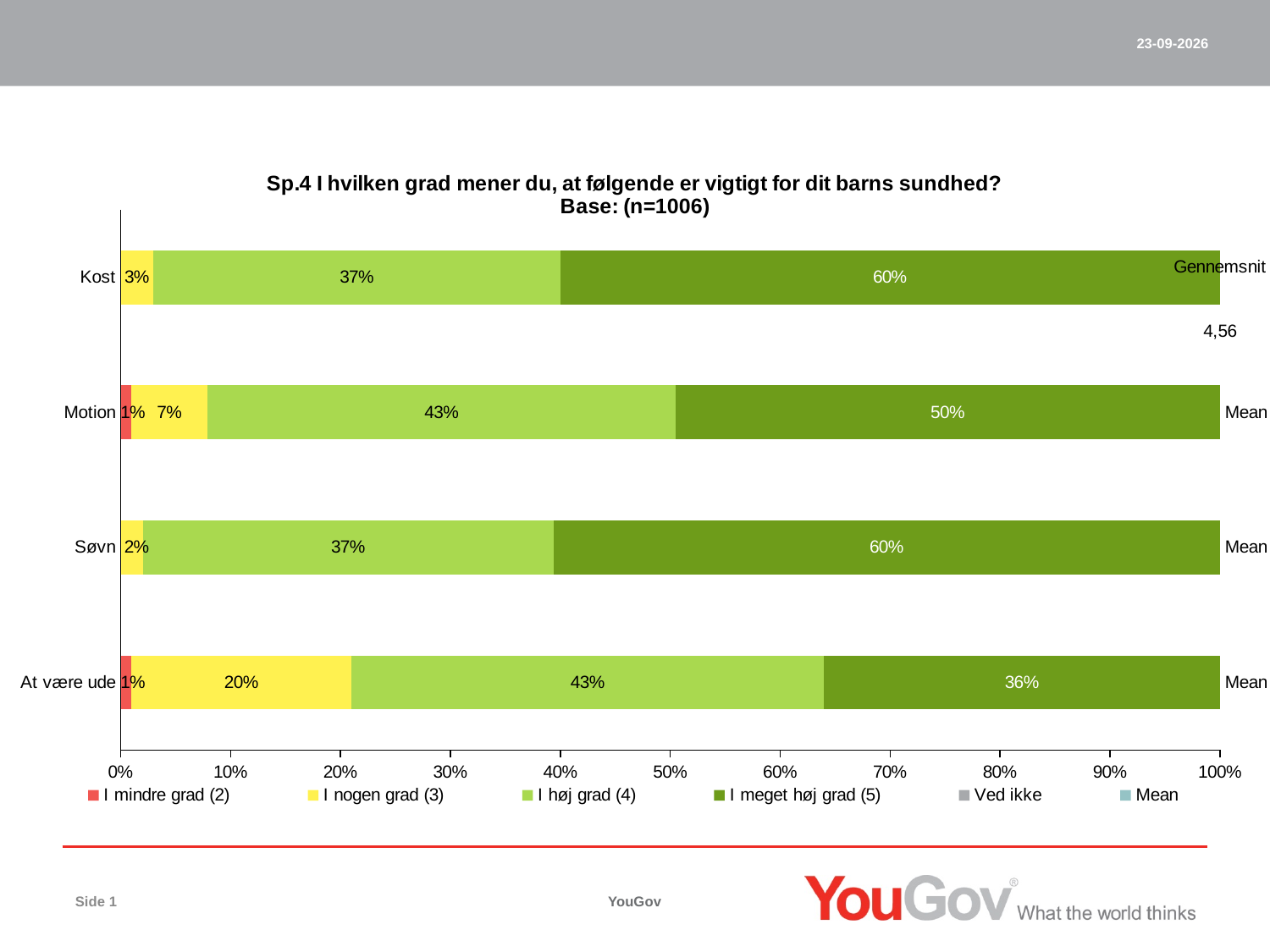
How many categories are shown on the y axis of the chart? 4 What is the value for 'I meget høj grad (5)' for Kost? 60% What is the value for 'I nogen grad (3)' for At være ude? 20% What kind of chart is shown on the slide? Stacked bar chart What is the Gennemsnit (mean) shown for Kost? 4,56 What is the value for 'I meget høj grad (5)' for Søvn? 60% Which category has the highest value for 'I nogen grad (3)'? At være ude What is the value for 'I høj grad (4)' for Motion? 43% How many entries does the legend list? 6 What is the difference between the 'I meget høj grad (5)' values for Motion and At være ude? 14 percentage points Which is larger: the 'I høj grad (4)' value for Motion or for Kost? Motion Which category has the lowest value for 'I meget høj grad (5)'? At være ude